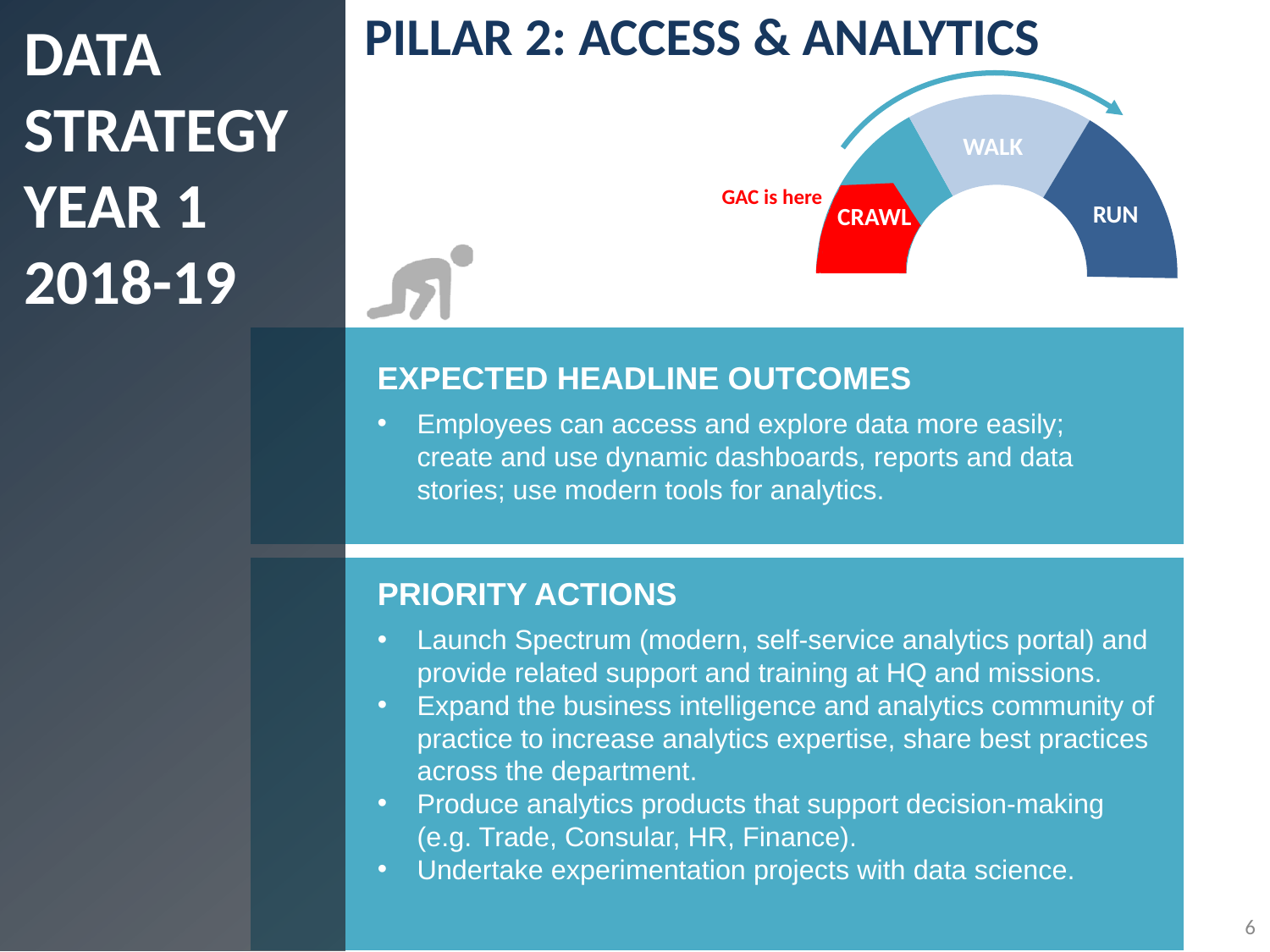
What kind of chart is shown at the top right of the slide? A gauge (semicircular doughnut) chart What are the three stage labels on the gauge chart, from left to right? CRAWL, WALK, RUN Which stage of the gauge chart is marked with the annotation "GAC is here"? CRAWL Which stage label appears in the dark blue segment on the right of the gauge chart? RUN How many labelled stages does the gauge chart show? 3 Which segment of the gauge chart is coloured red? CRAWL